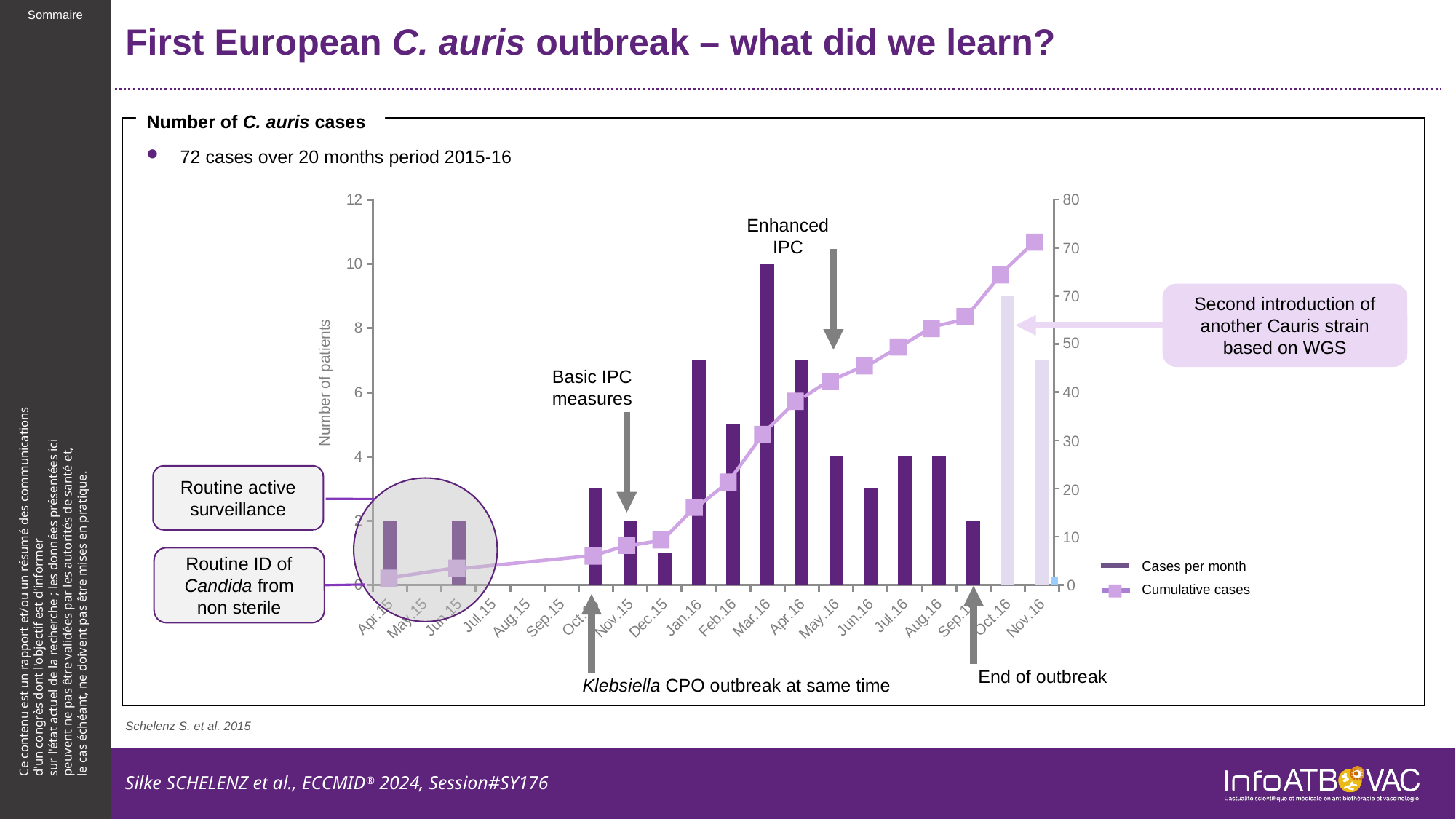
Is the number of cases per month for Dec.15 greater or less than 2? less Which month has the highest number of cases per month? Mar.16 How many cases per month are shown for Mar.16? 10 Which is larger, the cases per month for Feb.16 or for Jun.16? Feb.16 Does the cumulative cases line rise or fall from Apr.15 to Nov.16? rise How many months are shown on the x axis of the chart? 20 Is the number of cases per month for Jan.16 greater or less than 6? greater How many series does the chart legend list? 2 What kind of chart is shown on the slide? A combined bar and line chart What are the two series named in the chart legend? Cases per month and Cumulative cases What is the label of the left vertical axis? Number of patients How many cases per month are shown for Apr.15? 2